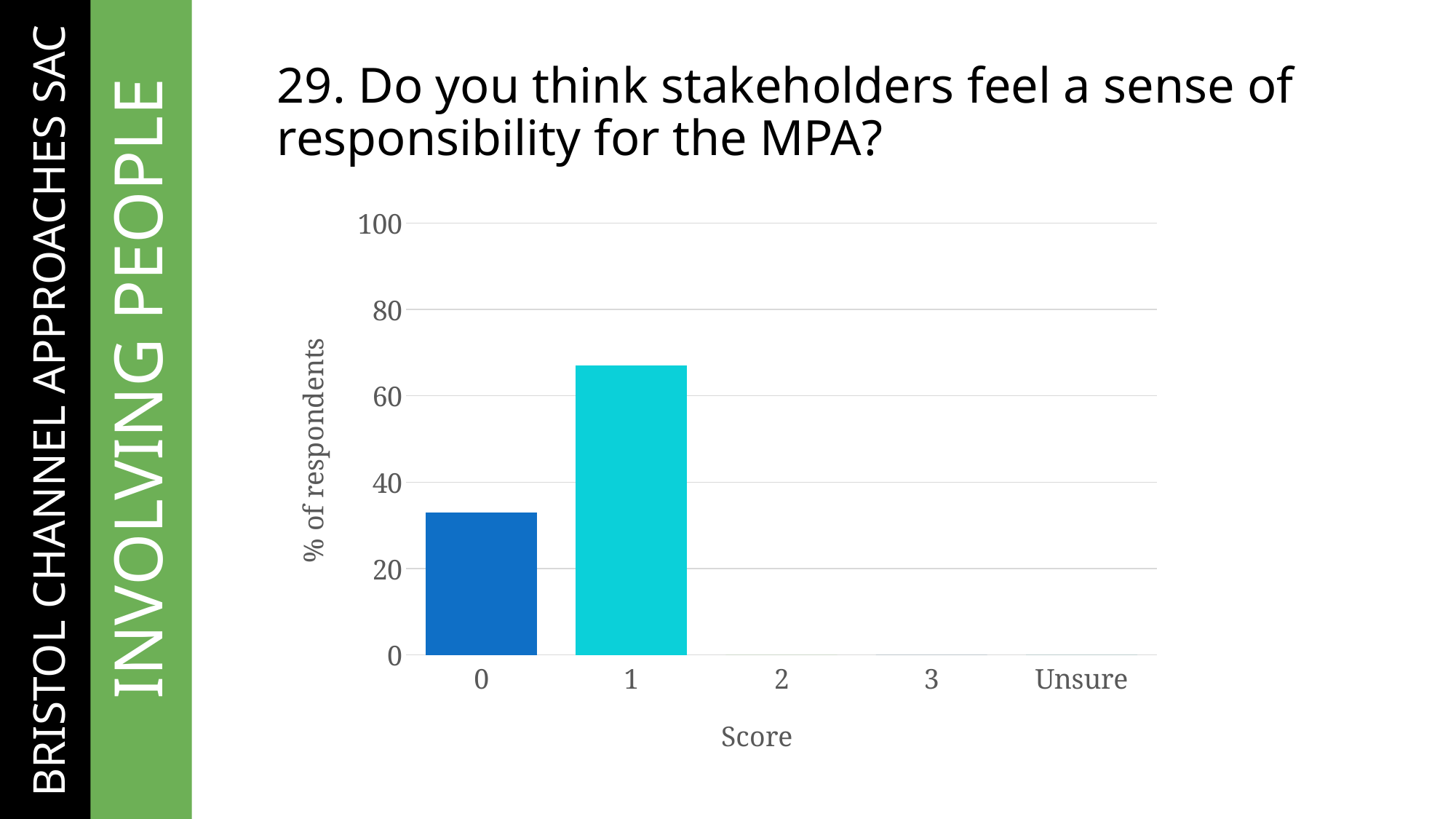
What kind of chart is shown on the slide? bar chart Which score has the highest percentage of respondents? 1 What is the label of the y axis? % of respondents Which has a larger percentage of respondents, score 0 or score 1? 1 What is the label of the x axis? Score How many score categories are shown on the x axis? 5 Is the value for score 1 greater or less than 60? greater Is the value for score 0 greater or less than 40? less What is the percentage of respondents for Unsure? 0 What is the percentage of respondents for score 2? 0 Is the value for score 0 greater or less than 20? greater